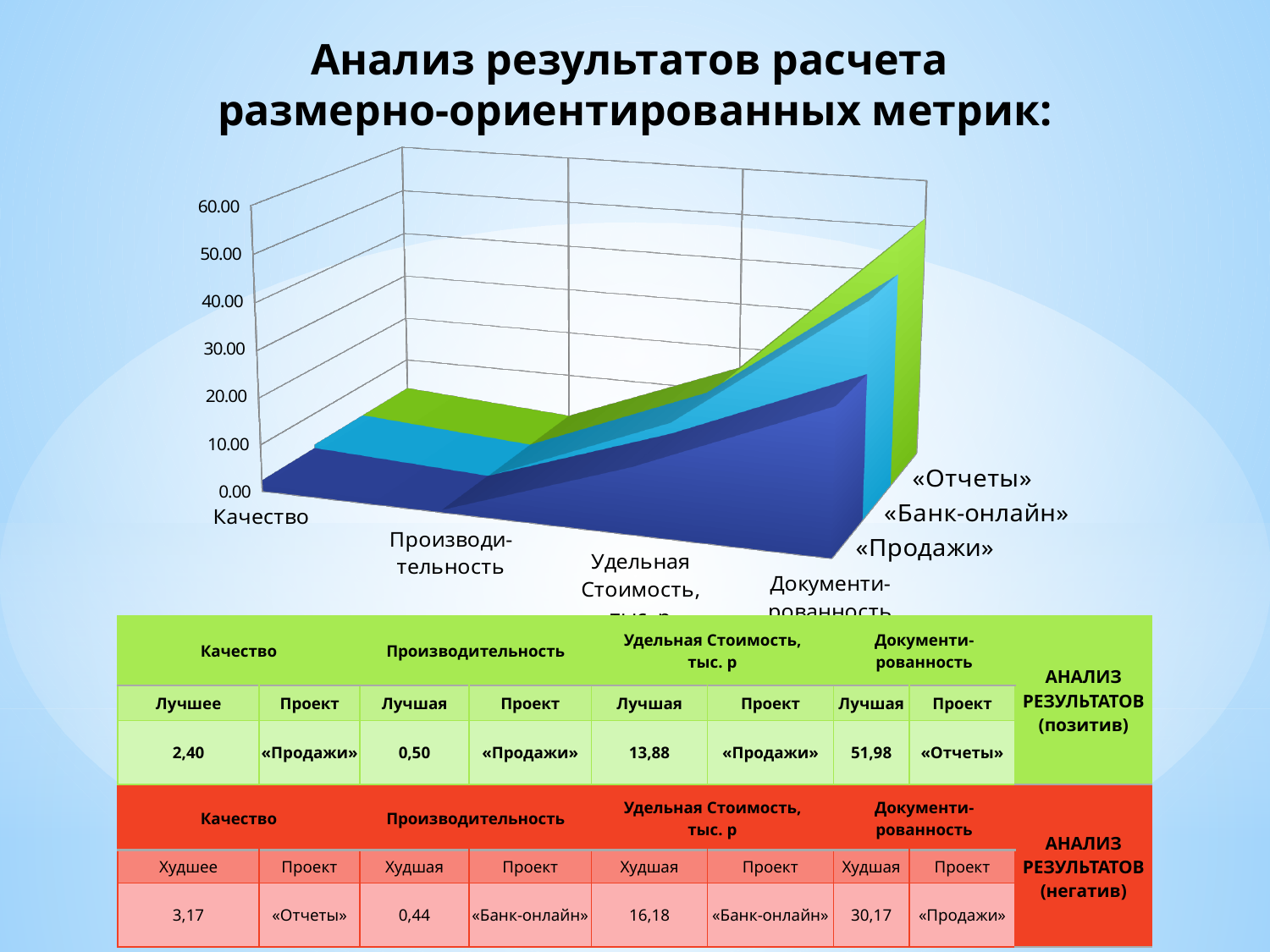
How many series does the chart plot? 3 Which series are plotted in the chart? «Продажи», «Банк-онлайн», «Отчеты» Do the values of the «Отчеты» series rise or fall from Качество to Документированность? rise Is the value of «Отчеты» for Производительность greater or less than 10.00? less For which category does the «Продажи» series have its lowest value? Производительность For which category does the «Отчеты» series reach its highest value? Документированность Which series has the larger value for Документированность, «Отчеты» or «Продажи»? «Отчеты» Is the value of «Продажи» for Качество greater or less than 10.00? less What is the highest value shown on the vertical axis of the chart? 60.00 Is the value of «Отчеты» for Документированность greater or less than 40.00? greater How many categories are shown along the x axis of the chart? 4 What kind of chart is shown on the slide? 3D area chart